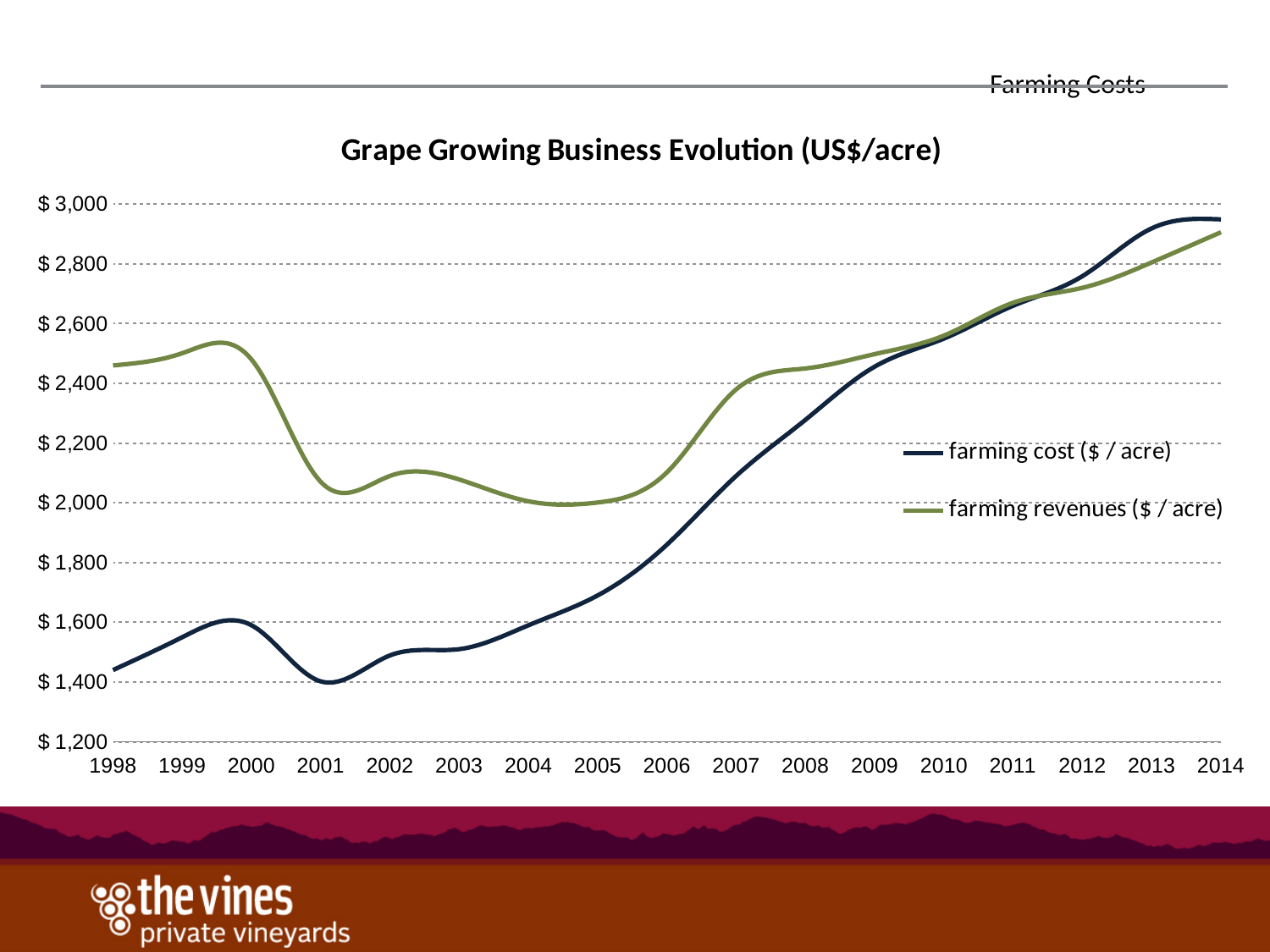
Does farming cost ($ / acre) rise or fall from 2005 to 2013? rise How many series does the legend list? 2 Is the farming cost ($ / acre) value for 2014 greater or less than $ 2,800? greater In 2005, which is larger: farming cost ($ / acre) or farming revenues ($ / acre)? farming revenues ($ / acre) Is the farming cost ($ / acre) value for 2007 greater or less than $ 2,200? less How many years are labelled on the x axis? 17 Which series is drawn in green? farming revenues ($ / acre) In which year is farming cost ($ / acre) at its lowest? 2001 Is the farming revenues ($ / acre) value for 1998 greater or less than $ 2,400? greater What is the title of the chart? Grape Growing Business Evolution (US$/acre) What kind of chart is shown on the slide? line chart